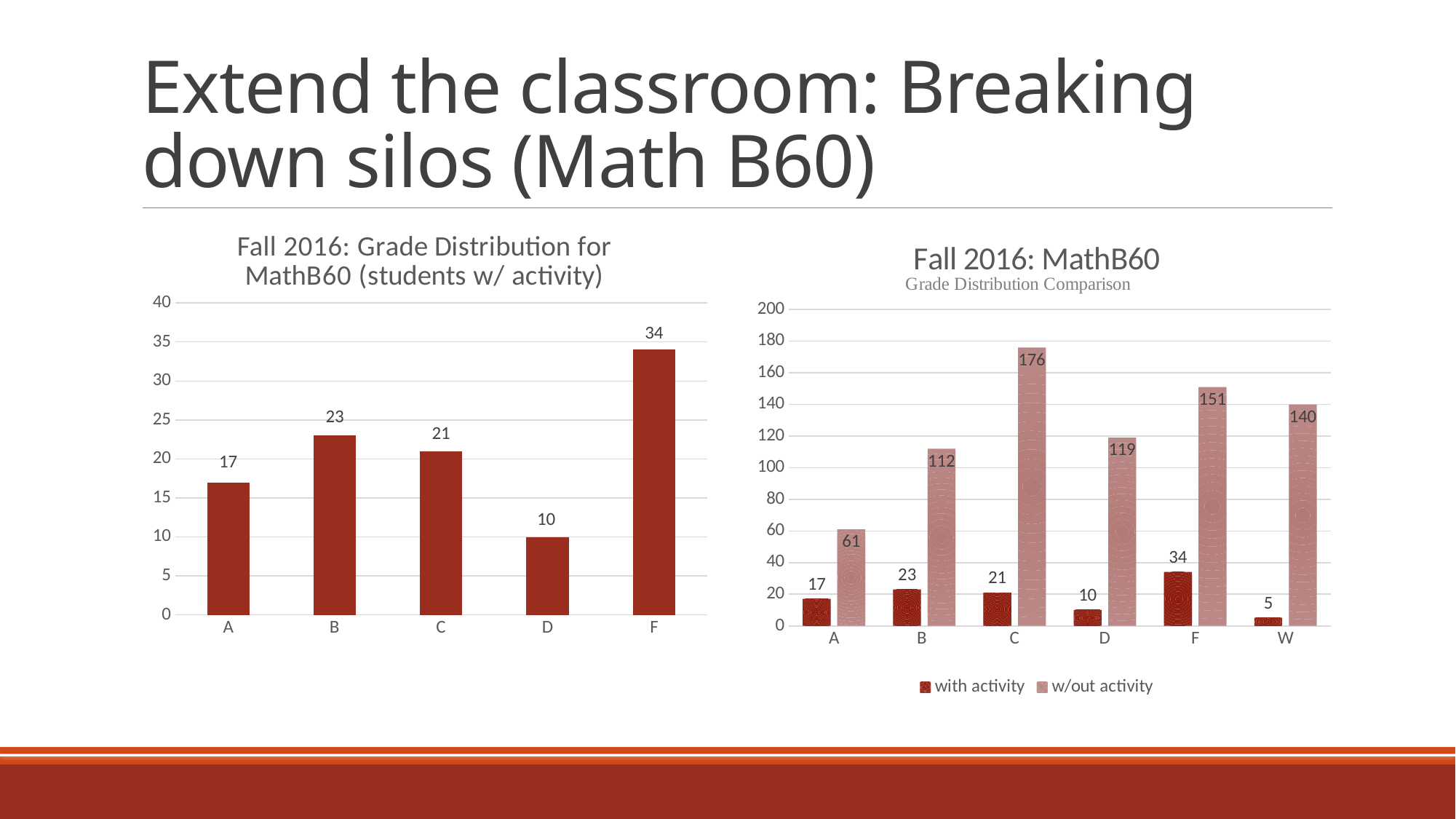
In the right chart (Grade Distribution Comparison), which grade has the highest w/out activity value? C In the left chart (students w/ activity), what is the difference between the values for F and D? 24 In the right chart (Fall 2016: MathB60 Grade Distribution Comparison), what is the value for grade C in the w/out activity series? 176 In the right chart (Grade Distribution Comparison), how many series does the legend list? 2 In the left chart (students w/ activity), how many grade categories are shown on the x axis? 5 In the left chart (students w/ activity), which grade has the lowest value? D In the right chart (Grade Distribution Comparison), what is the value for grade W in the with activity series? 5 In the left chart (Fall 2016: Grade Distribution for MathB60, students w/ activity), what is the value for grade B? 23 In the right chart (Grade Distribution Comparison), what is the difference between the w/out activity and with activity values for grade F? 117 In the left chart (students w/ activity), which grade has the highest value? F What kind of chart is the right chart (Fall 2016: MathB60 Grade Distribution Comparison)? bar chart In the right chart (Grade Distribution Comparison), which is larger: the w/out activity value for D or for W? W